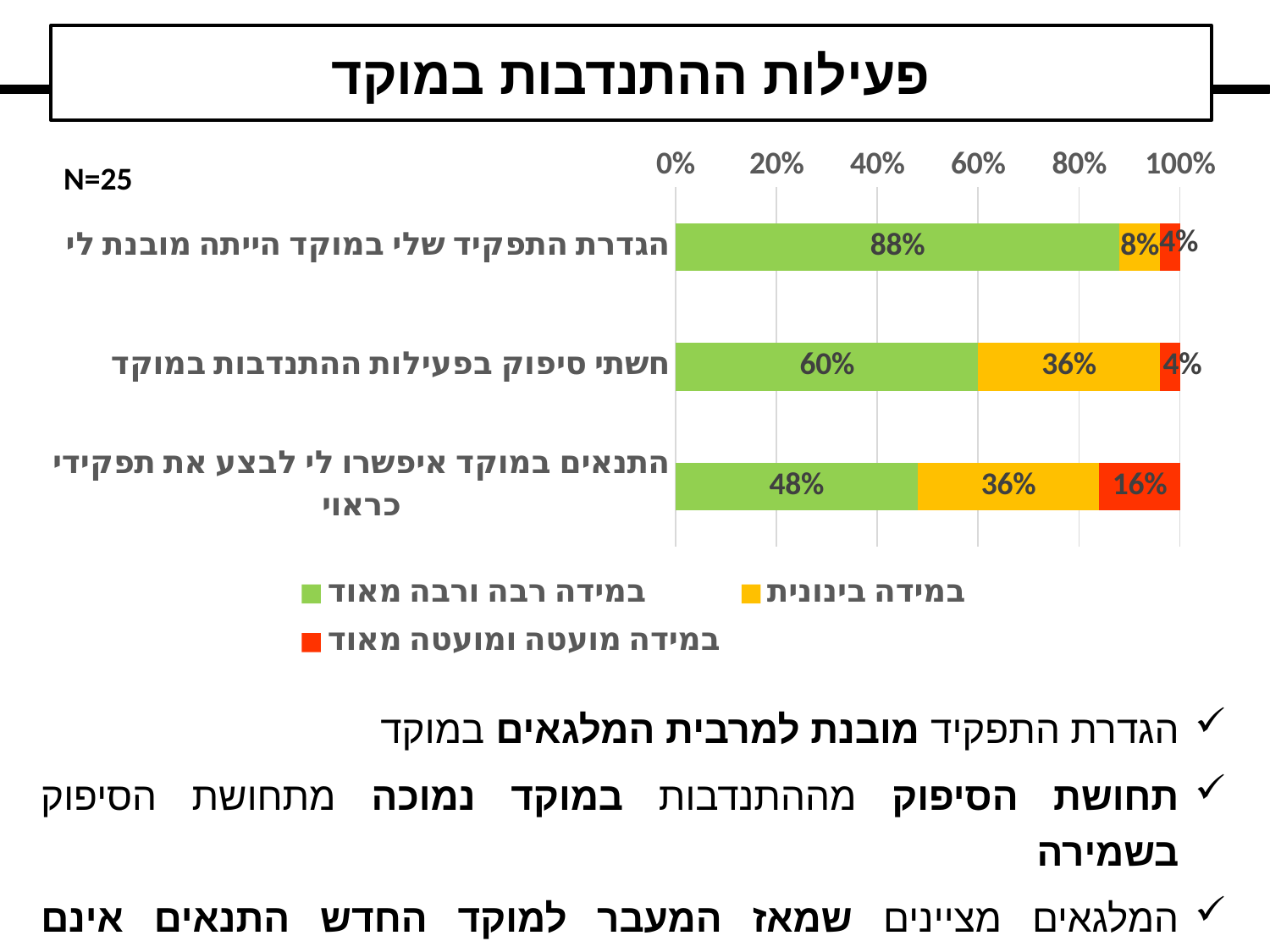
What kind of chart is shown on the slide? Stacked bar chart How many categories (statements) are plotted in the chart? 3 What is the value of the 'במידה בינונית' series for 'חשתי סיפוק בפעילות ההתנדבות במוקד'? 36% Which statement has the highest value for the 'במידה רבה ורבה מאוד' series? הגדרת התפקיד שלי במוקד הייתה מובנת לי Which is larger: the 'במידה מועטה ומועטה מאוד' value for 'התנאים במוקד איפשרו לי לבצע את תפקידי כראוי' or for 'חשתי סיפוק בפעילות ההתנדבות במוקד'? התנאים במוקד איפשרו לי לבצע את תפקידי כראוי What is the difference between the 'במידה רבה ורבה מאוד' values for 'הגדרת התפקיד שלי במוקד הייתה מובנת לי' and 'חשתי סיפוק בפעילות ההתנדבות במוקד'? 28% What is the sample size (N) shown on the slide? N=25 Which statement has the lowest value for the 'במידה רבה ורבה מאוד' series? התנאים במוקד איפשרו לי לבצע את תפקידי כראוי What is the total of the stacked bar for 'חשתי סיפוק בפעילות ההתנדבות במוקד'? 100% How many series does the chart legend list? 3 What is the value of the 'במידה מועטה ומועטה מאוד' series for 'התנאים במוקד איפשרו לי לבצע את תפקידי כראוי'? 16% What is the value of the 'במידה רבה ורבה מאוד' series for 'הגדרת התפקיד שלי במוקד הייתה מובנת לי'? 88%